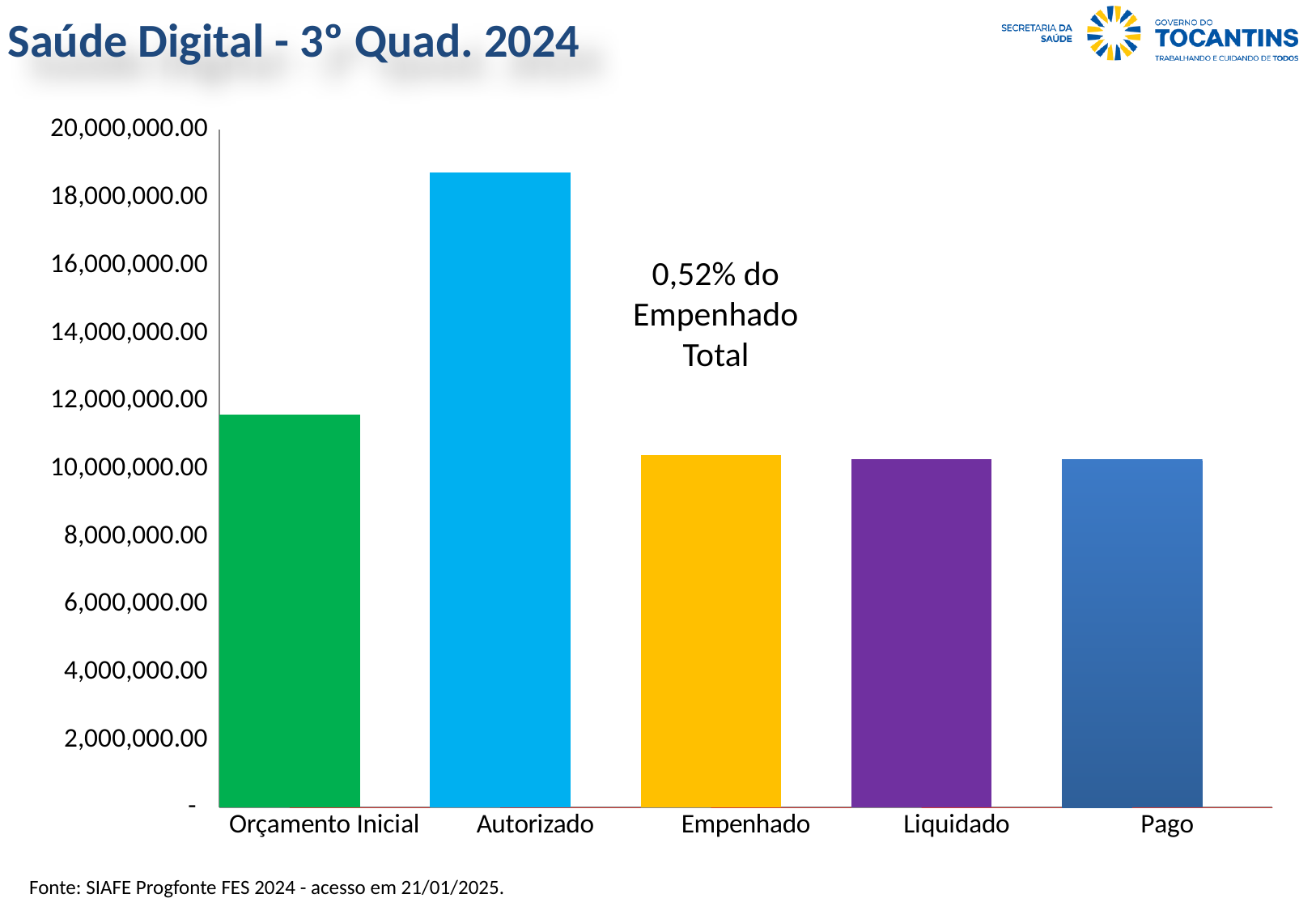
Is the value for Pago greater or less than 12,000,000.00? less What kind of chart is shown on the slide? bar chart Is the value for Empenhado greater or less than 10,000,000.00? greater What percentage of the Empenhado Total does the annotation on the chart state? 0,52% Is the value for Orçamento Inicial greater or less than 12,000,000.00? less What is the title of the slide containing the chart? Saúde Digital - 3° Quad. 2024 Which is larger, the value for Autorizado or the value for Orçamento Inicial? Autorizado Which category has the highest value in the chart? Autorizado Which is larger, the value for Orçamento Inicial or the value for Empenhado? Orçamento Inicial How many categories are shown on the x axis of the chart? 5